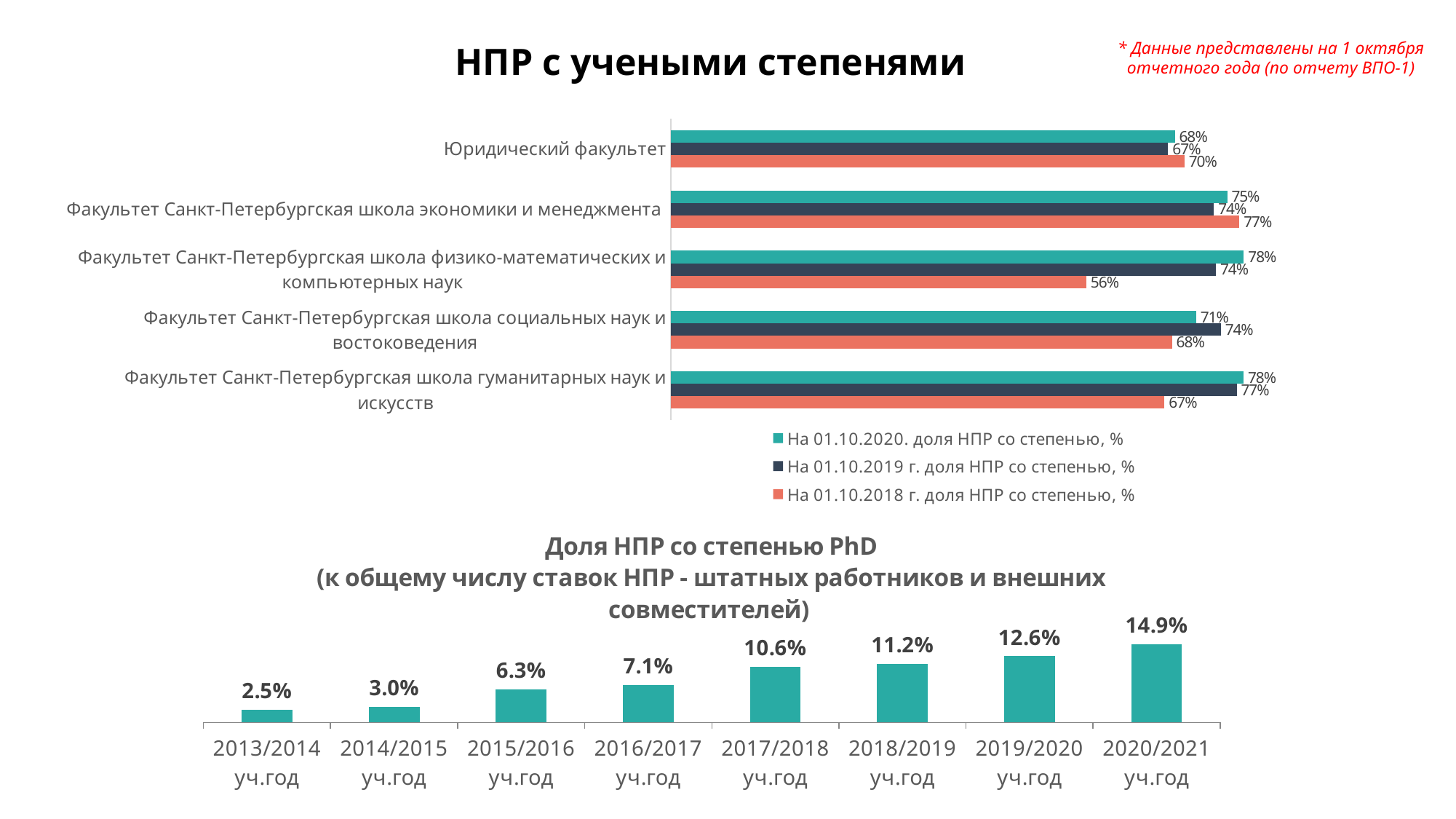
What type of chart is the bottom chart (Доля НПР со степенью PhD)? Bar chart In the bottom chart (Доля НПР со степенью PhD), do the values rise or fall from 2013/2014 to 2020/2021? Rise In the bottom chart (Доля НПР со степенью PhD), what is the difference between the values for 2020/2021 уч.год and 2013/2014 уч.год? 12.4% How many series does the legend of the top chart (НПР с учеными степенями) list? 3 In the bottom chart (Доля НПР со степенью PhD), which academic year has the highest value? 2020/2021 уч.год In the bottom chart (Доля НПР со степенью PhD), what is the value for 2017/2018 уч.год? 10.6% In the top chart (НПР с учеными степенями), which is larger for Факультет Санкт-Петербургская школа социальных наук и востоковедения: the 01.10.2019 value or the 01.10.2020 value? 01.10.2019 (74%) In the top chart (НПР с учеными степенями), which faculty has the lowest value for 01.10.2018? Факультет Санкт-Петербургская школа физико-математических и компьютерных наук In the top chart (НПР с учеными степенями), what is the difference between the 2020 and 2018 values for Факультет Санкт-Петербургская школа физико-математических и компьютерных наук? 22% In the top chart (НПР с учеными степенями), what is the value for Юридический факультет on 01.10.2020? 68% How many faculties are shown in the top chart (НПР с учеными степенями)? 5 In the top chart (НПР с учеными степенями), what is the value for Факультет Санкт-Петербургская школа физико-математических и компьютерных наук on 01.10.2018? 56%